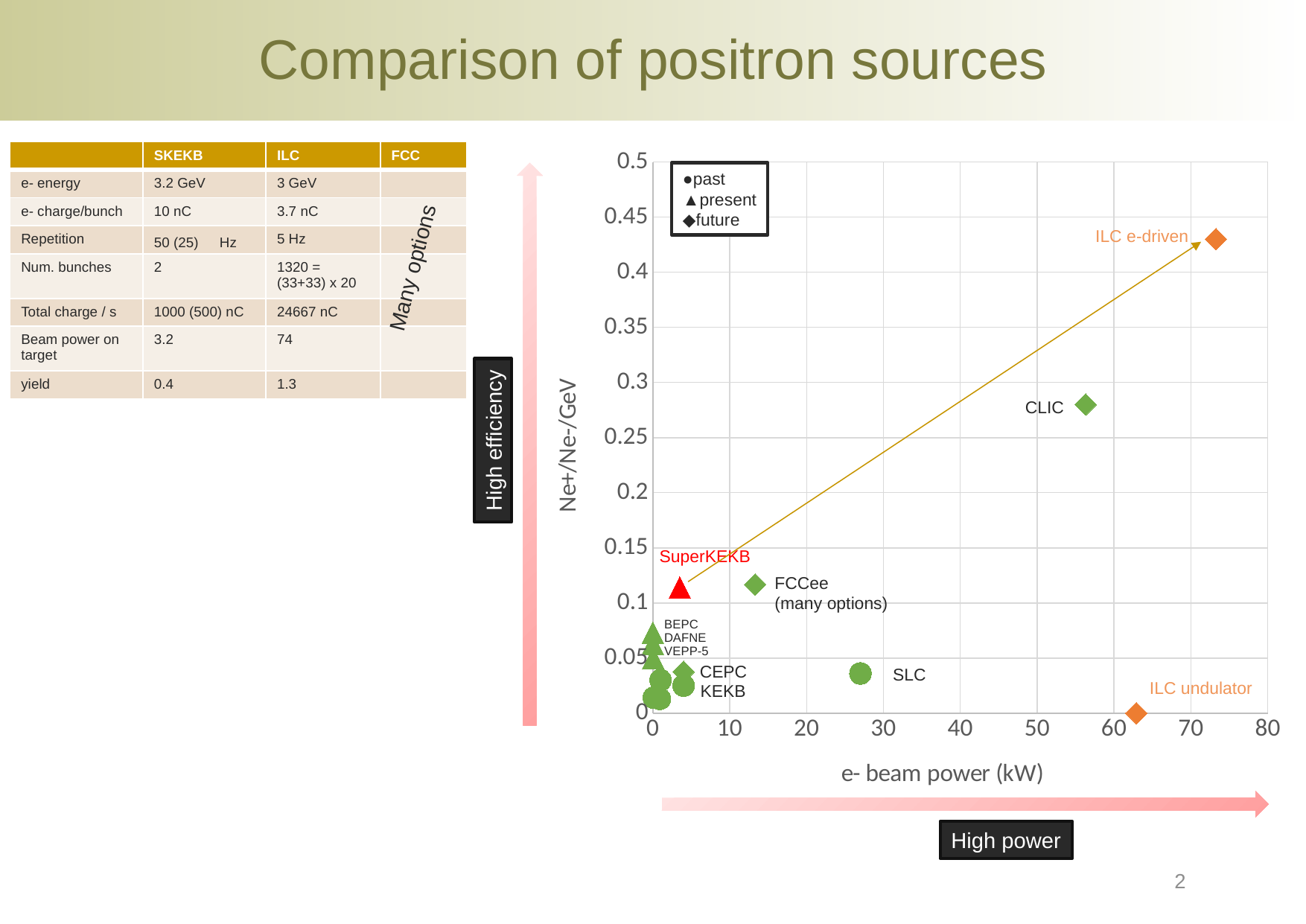
How many marker categories does the chart legend list? 3 Is the e- beam power for SLC greater or less than 20 kW? greater Which has a higher Ne+/Ne-/GeV value, CLIC or SLC? CLIC Is the Ne+/Ne-/GeV value for ILC e-driven greater or less than 0.4? greater Is the Ne+/Ne-/GeV value for ILC undulator greater or less than 0.05? less Which has a higher e- beam power, ILC undulator or FCCee? ILC undulator What are the three categories listed in the chart legend? past, present, future Which positron source has the highest Ne+/Ne-/GeV value in the chart? ILC e-driven What kind of chart is shown on the slide? scatter chart Which labelled positron source has the highest e- beam power (kW) in the chart? ILC e-driven What is the label of the x axis of the chart? e- beam power (kW)